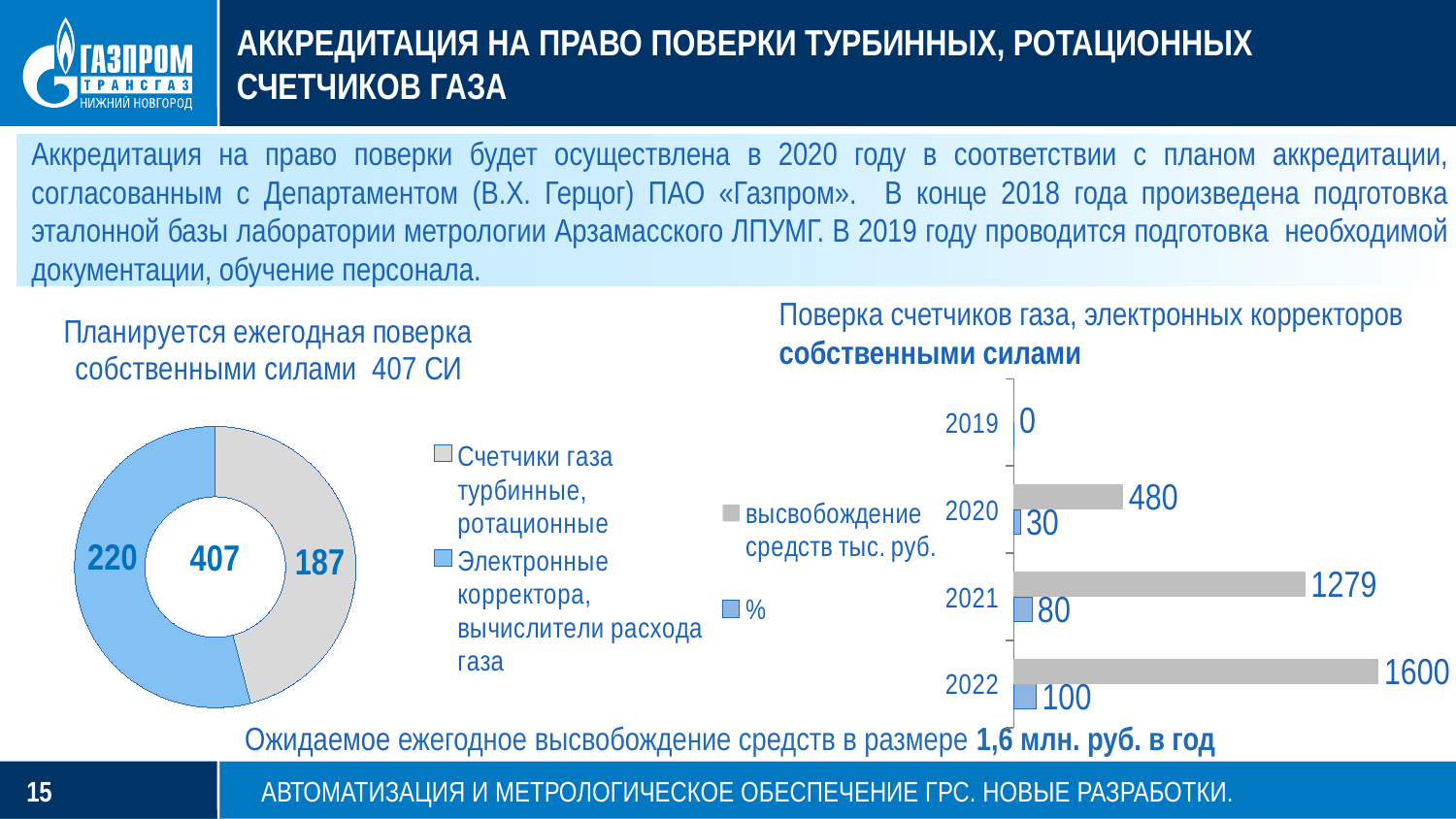
In the bar chart on the right, what is the difference between the 'высвобождение средств тыс. руб.' values for 2022 and 2021? 321 In the bar chart on the right, what is the '%' value for 2021? 80 In the bar chart on the right, what is the '%' value for 2020? 30 In the bar chart on the right, how many series does the legend list? 2 In the bar chart on the right, what is the value of 'высвобождение средств тыс. руб.' for 2021? 1279 In the bar chart on the right, which year has the highest value of 'высвобождение средств тыс. руб.'? 2022 In the bar chart on the right, what is the value of 'высвобождение средств тыс. руб.' for 2022? 1600 In the doughnut chart on the left, what is the difference between the two slice values? 33 In the bar chart on the right, do the 'высвобождение средств тыс. руб.' values rise or fall from 2019 to 2022? rise In the doughnut chart on the left, which category is larger: 'Счетчики газа турбинные, ротационные' or 'Электронные корректора, вычислители расхода газа'? Электронные корректора, вычислители расхода газа In the doughnut chart on the left, what is the value for 'Электронные корректора, вычислители расхода газа'? 220 What kind of chart is the chart on the right? bar chart